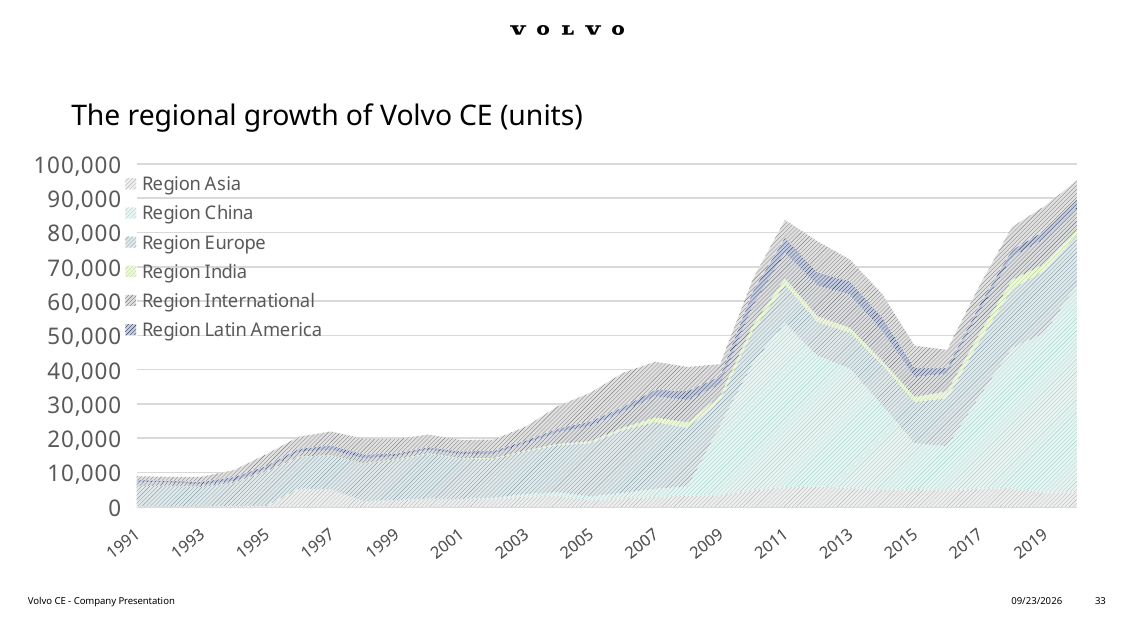
Which series is listed first in the legend? Region Asia What kind of chart is shown on the slide? Area chart Which is larger, the total value for 2011 or for 2015? 2011 Is the total value for 2017 greater or less than 60,000? greater How many series does the legend list? 6 Does the total value rise or fall between 2011 and 2015? fall What is the title of the chart? The regional growth of Volvo CE (units) Does the total value rise or fall between 2015 and 2019? rise Is the total value for 2015 greater or less than 50,000? less Is the total value for 2009 greater or less than 50,000? less How many year labels are shown on the x axis? 15